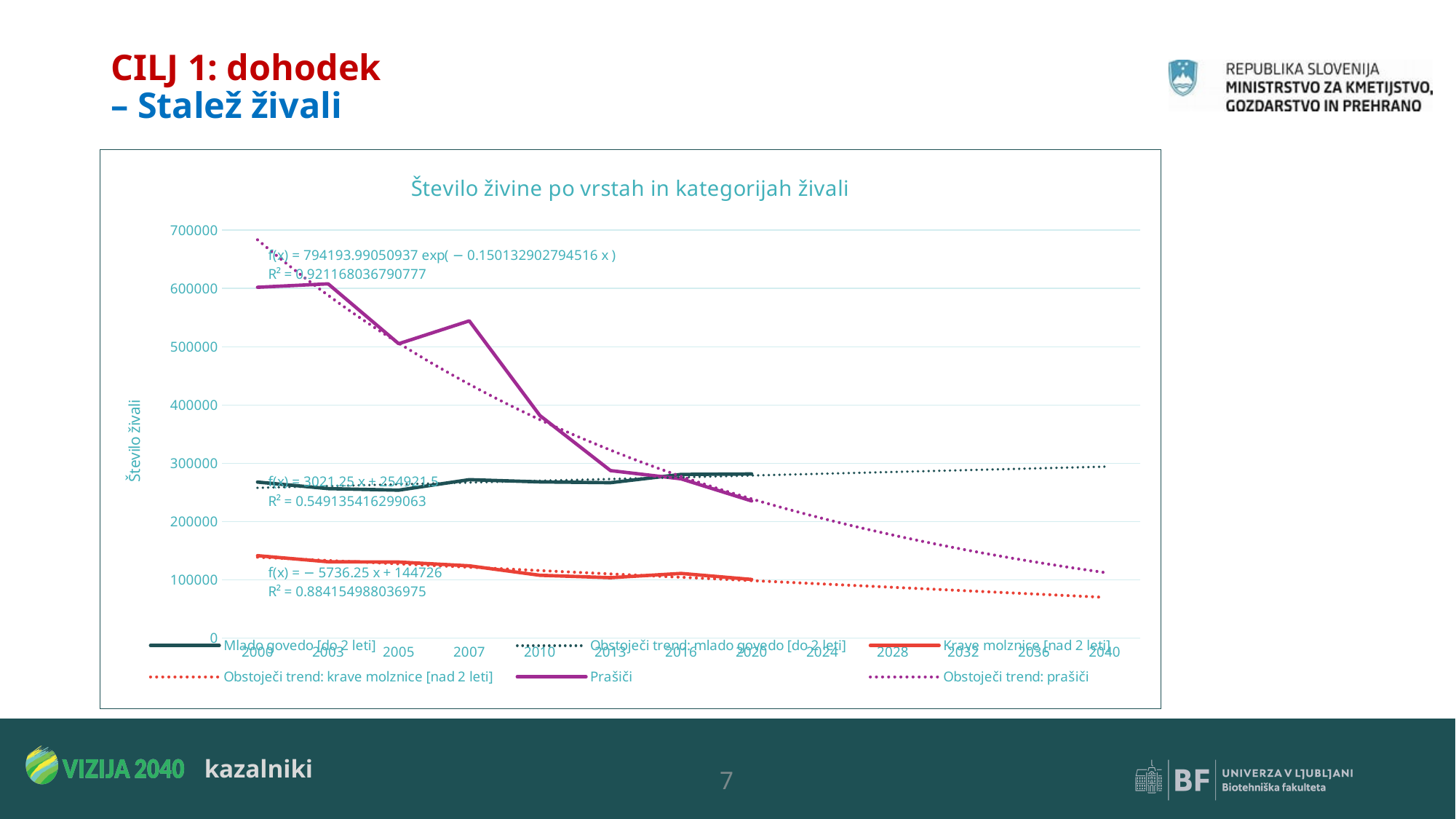
How many entries does the chart legend list? 6 What is the title of the chart? Število živine po vrstah in kategorijah živali Is the value for Mlado govedo [do 2 leti] in 2020 greater or less than 200000? greater Which series has the highest value in 2000? Prašiči In 2007, which is larger: the value for Prašiči or the value for Mlado govedo [do 2 leti]? Prašiči Does the Krave molznice [nad 2 leti] series rise or fall between 2000 and 2020? fall Is the value for Prašiči in 2020 greater or less than 300000? less Which series has the lowest value in 2020? Krave molznice [nad 2 leti] Does the Prašiči series rise or fall between 2000 and 2020? fall What kind of chart is shown on the slide? line chart Is the value for Krave molznice [nad 2 leti] in 2000 greater or less than 200000? less